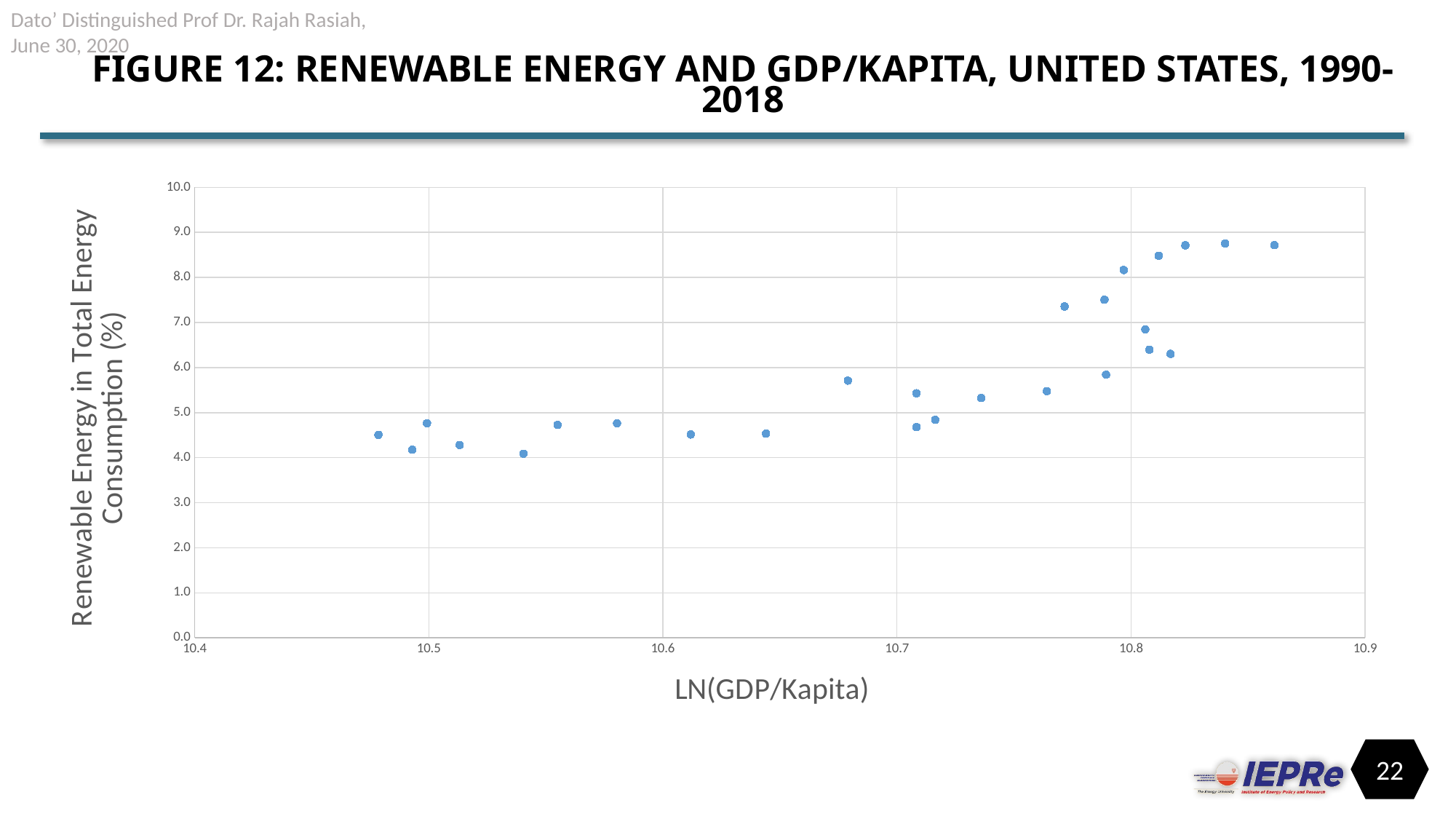
What is the title of the chart on the slide? FIGURE 12: RENEWABLE ENERGY AND GDP/KAPITA, UNITED STATES, 1990-2018 Is the highest plotted renewable energy value greater or less than 8.0? greater Overall, do the plotted values of renewable energy share rise or fall as LN(GDP/Kapita) increases? Rise Are any plotted points above 9.0 on the vertical axis? No Is the renewable energy value for the point at roughly LN(GDP/Kapita) 10.54 greater or less than 5.0? less What is the label of the horizontal axis of the chart? LN(GDP/Kapita) What kind of chart is shown on the slide? Scatter chart Which has the larger renewable energy value: the point near LN(GDP/Kapita) 10.86 or the point near 10.48? The point near 10.86